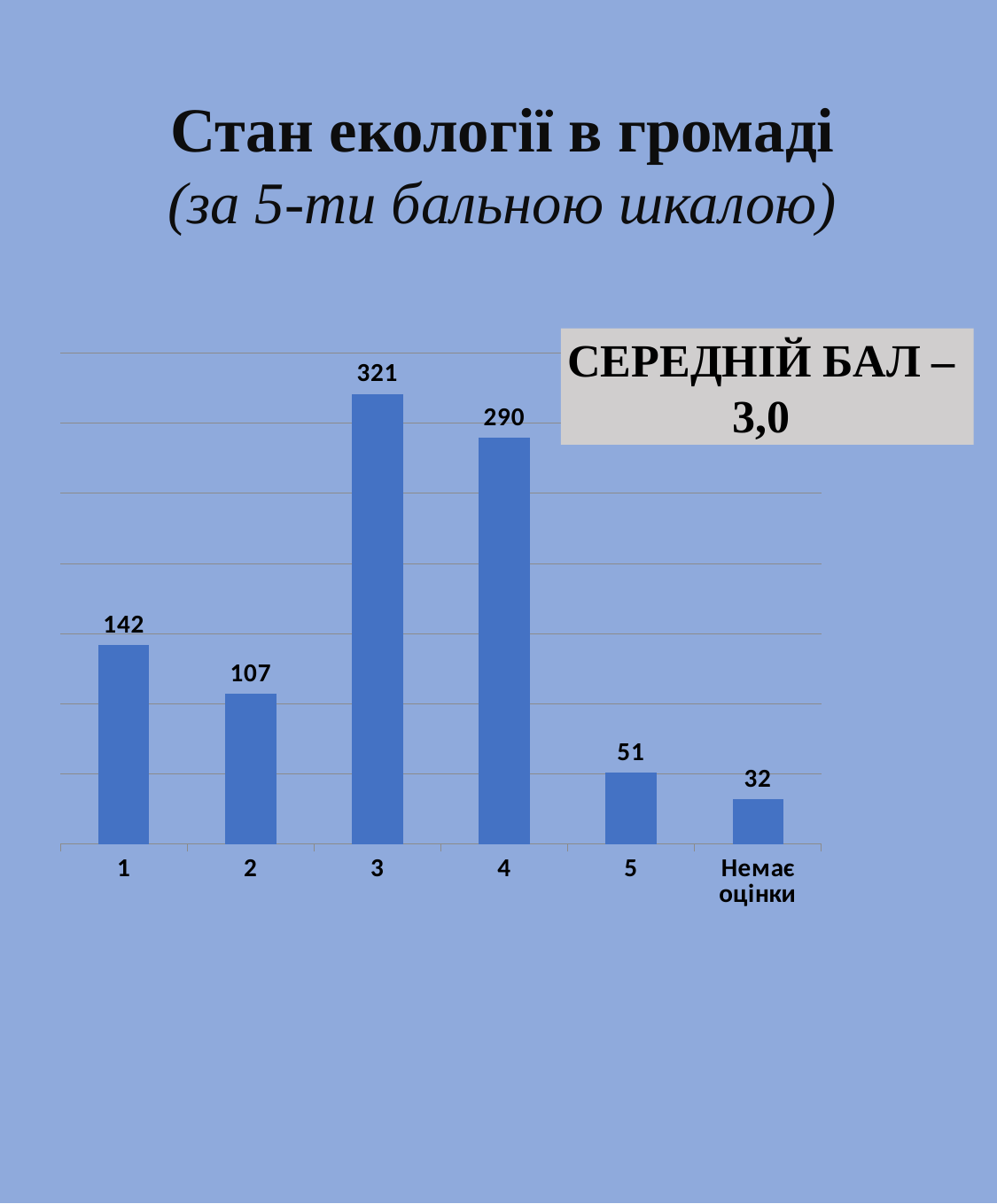
How many categories are shown on the x axis? 6 What kind of chart is shown on the slide? bar chart Which category has the highest value? 3 Which category has the lowest value? Немає оцінки What is the value for the 'Немає оцінки' category? 32 What is the difference between the values for categories 1 and 2? 35 What is the value for category 1? 142 What is the value for category 5? 51 What average score (середній бал) is stated on the slide? 3,0 What is the value for category 3? 321 Which is larger, the value for category 4 or the value for category 1? 4 What is the difference between the values for categories 3 and 4? 31